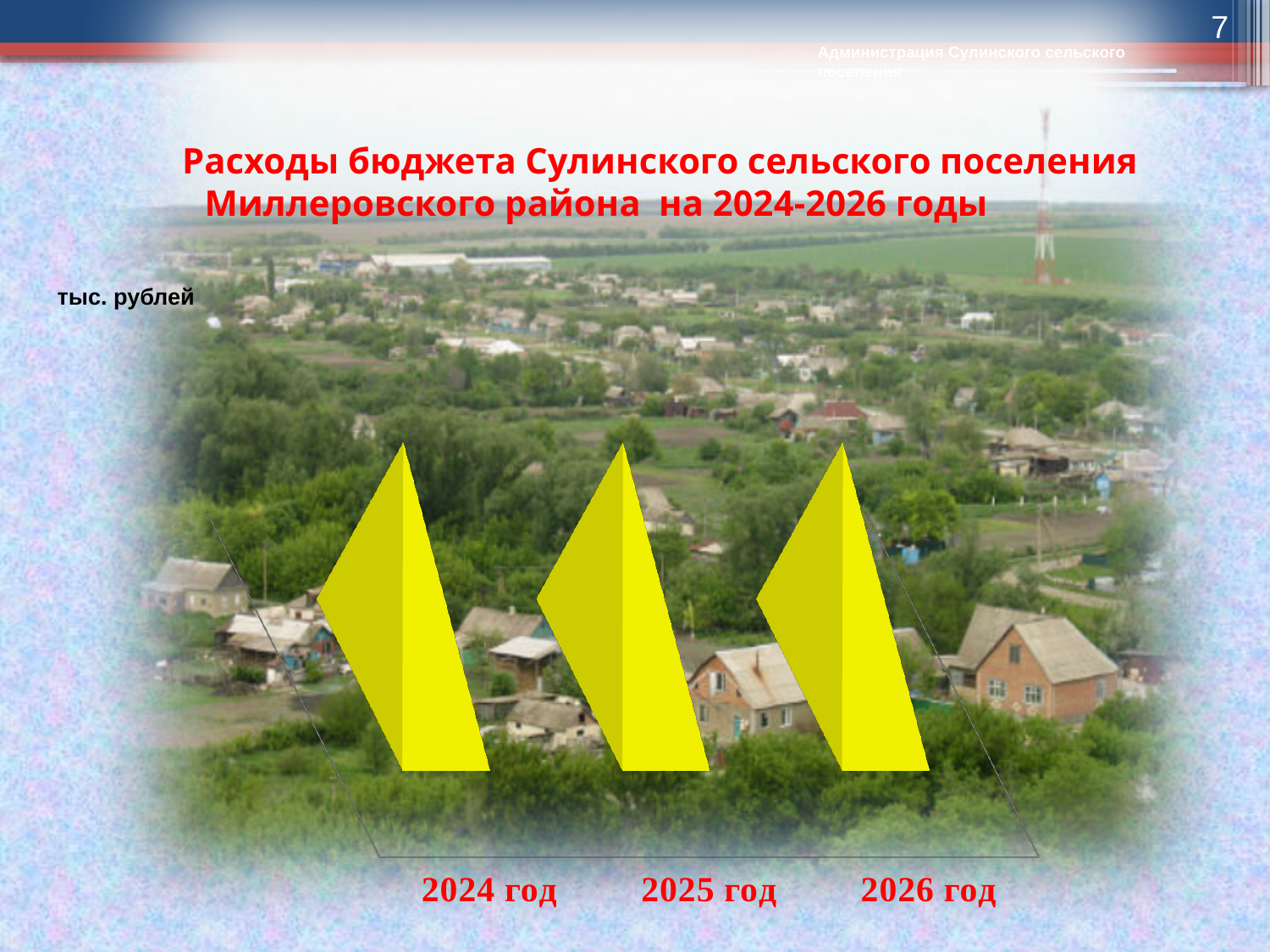
What is the title of the chart on the slide? Расходы бюджета Сулинского сельского поселения Миллеровского района на 2024-2026 годы How many categories are shown on the x axis of the chart? 3 Which category is shown last (rightmost) on the x axis of the chart? 2026 год Which category is shown first (leftmost) on the x axis of the chart? 2024 год What are the categories shown along the x axis of the chart? 2024 год, 2025 год, 2026 год What kind of chart is shown on the slide? bar chart